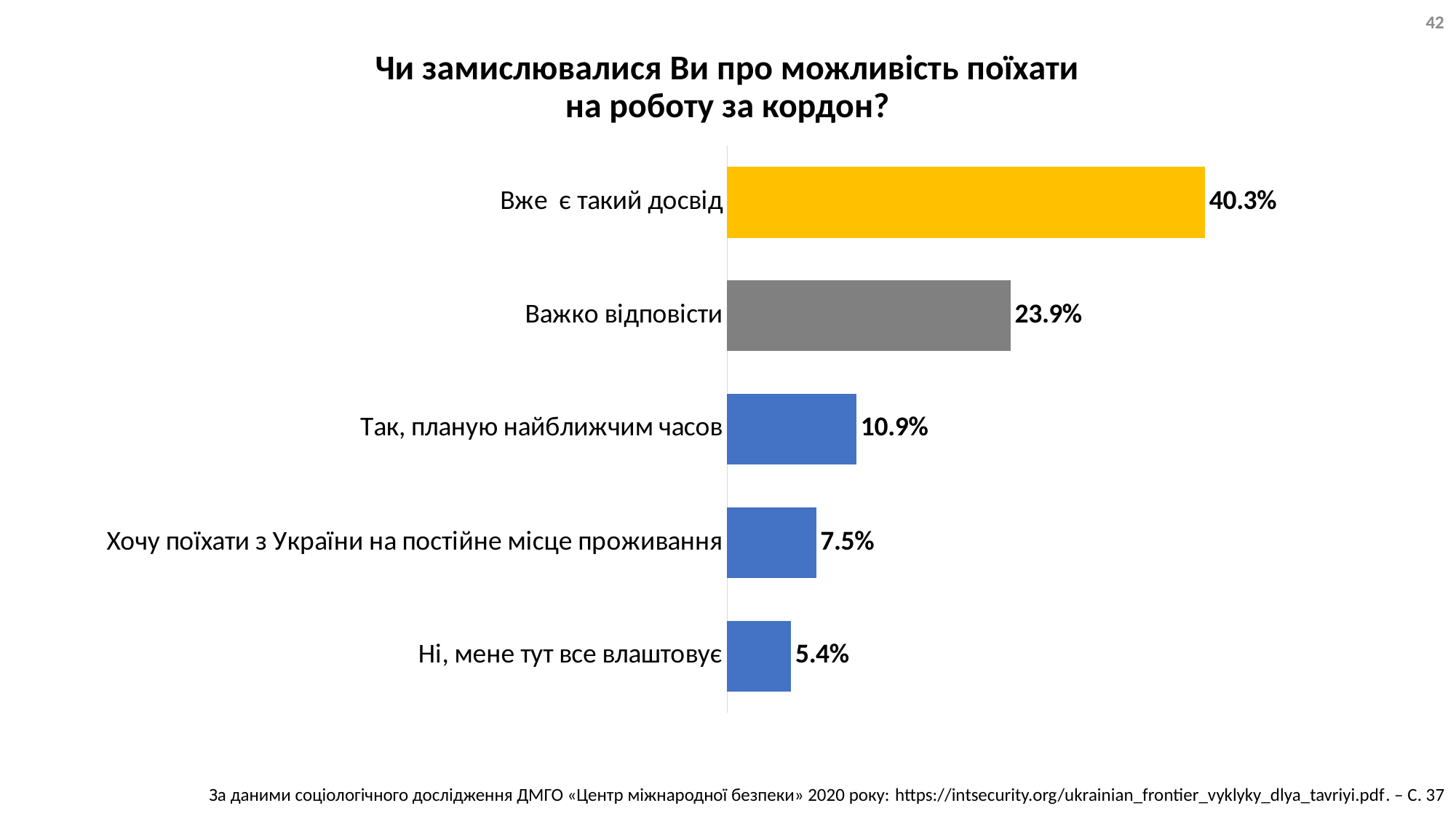
What kind of chart is shown on the slide? Bar chart What is the difference between the values for "Вже є такий досвід" and "Важко відповісти"? 16.4% What colour is the bar for "Важко відповісти"? Grey What is the value for "Так, планую найближчим часов"? 10.9% What is the value for "Ні, мене тут все влаштовує"? 5.4% What is the difference between the values for "Хочу поїхати з України на постійне місце проживання" and "Ні, мене тут все влаштовує"? 2.1% How many categories are shown in the chart? 5 Which category has the lowest value? Ні, мене тут все влаштовує What is the value for "Вже є такий досвід"? 40.3% Which category has the highest value? Вже є такий досвід What is the value for "Важко відповісти"? 23.9% Which is larger: the value for "Так, планую найближчим часов" or for "Хочу поїхати з України на постійне місце проживання"? Так, планую найближчим часов